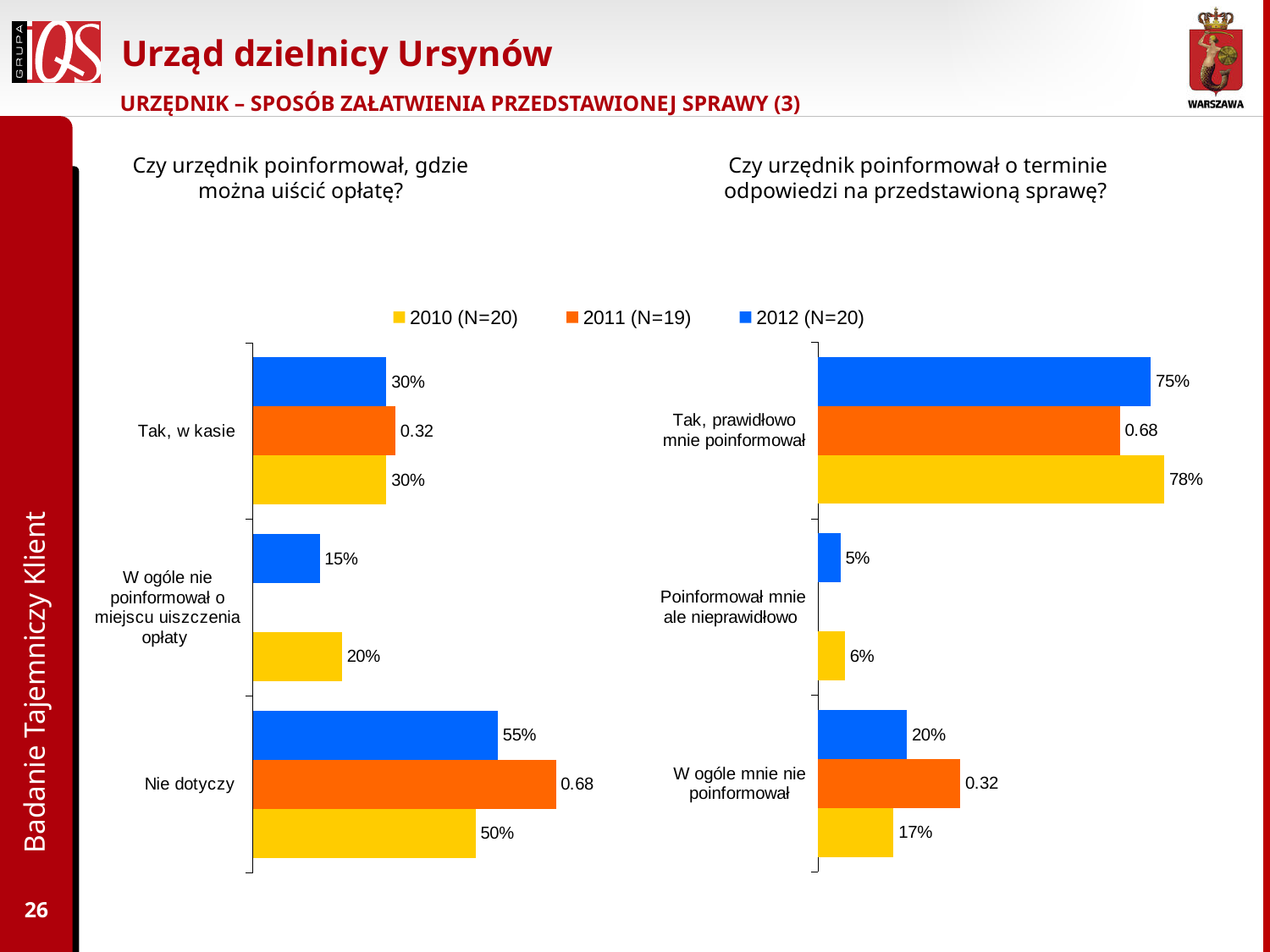
In the right chart (Czy urzędnik poinformował o terminie odpowiedzi na przedstawioną sprawę?), what is the difference between the 2010 values for 'Tak, prawidłowo mnie poinformował' and 'W ogóle mnie nie poinformował'? 61 percentage points In the left chart (Czy urzędnik poinformował, gdzie można uiścić opłatę?), which category has the lowest 2010 value? W ogóle nie poinformował o miejscu uiszczenia opłaty In the left chart (Czy urzędnik poinformował, gdzie można uiścić opłatę?), what is the difference between the 2012 values for 'Nie dotyczy' and 'Tak, w kasie'? 25 percentage points How many series does the legend list? 3 In the left chart (Czy urzędnik poinformował, gdzie można uiścić opłatę?), what is the 2012 value for 'Nie dotyczy'? 55% In the right chart (Czy urzędnik poinformował o terminie odpowiedzi na przedstawioną sprawę?), what is the 2010 value for 'Tak, prawidłowo mnie poinformował'? 78% In the left chart (Czy urzędnik poinformował, gdzie można uiścić opłatę?), what is the 2011 value for 'Tak, w kasie'? 0.32 How many categories are shown in the left chart (Czy urzędnik poinformował, gdzie można uiścić opłatę?)? 3 In the right chart (Czy urzędnik poinformował o terminie odpowiedzi na przedstawioną sprawę?), which is larger for 'W ogóle mnie nie poinformował': the 2012 value or the 2010 value? 2012 What kind of chart is the right chart (Czy urzędnik poinformował o terminie odpowiedzi na przedstawioną sprawę?)? Bar chart In the right chart (Czy urzędnik poinformował o terminie odpowiedzi na przedstawioną sprawę?), which category has the highest 2012 value? Tak, prawidłowo mnie poinformował In the right chart (Czy urzędnik poinformował o terminie odpowiedzi na przedstawioną sprawę?), what is the 2012 value for 'W ogóle mnie nie poinformował'? 20%